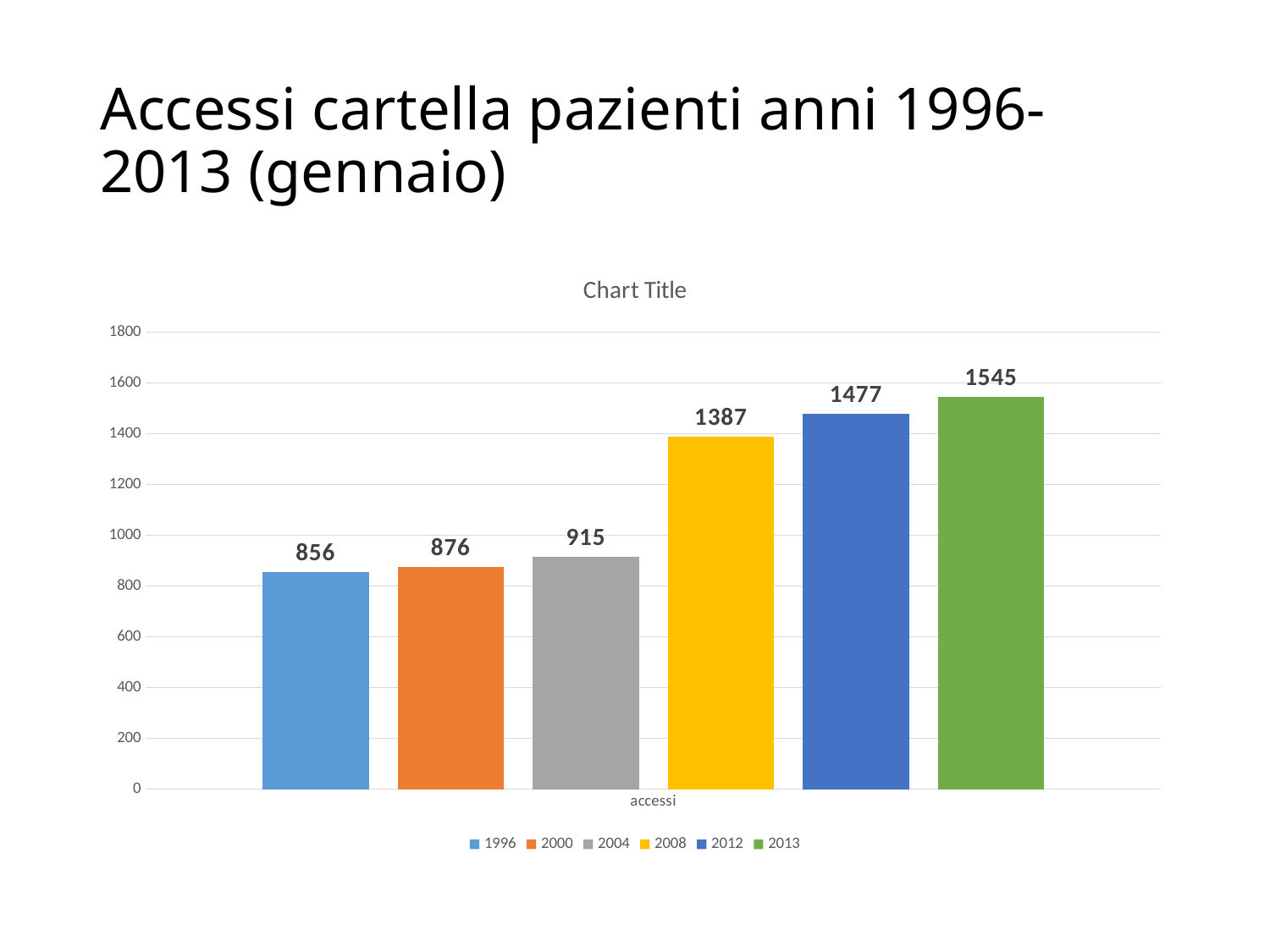
Is the value for 2012 greater or less than 1400? greater What is the difference between the values for 2012 and 2008? 90 What is the label on the x axis category? accessi What is the value for 1996? 856 What is the value for 2013? 1545 What kind of chart is shown? bar chart Which year has the lowest value? 1996 Which is larger, the value for 2004 or the value for 2000? 2004 What is the difference between the values for 2013 and 1996? 689 Which year has the highest value? 2013 What is the value for 2008? 1387 How many series does the legend list? 6